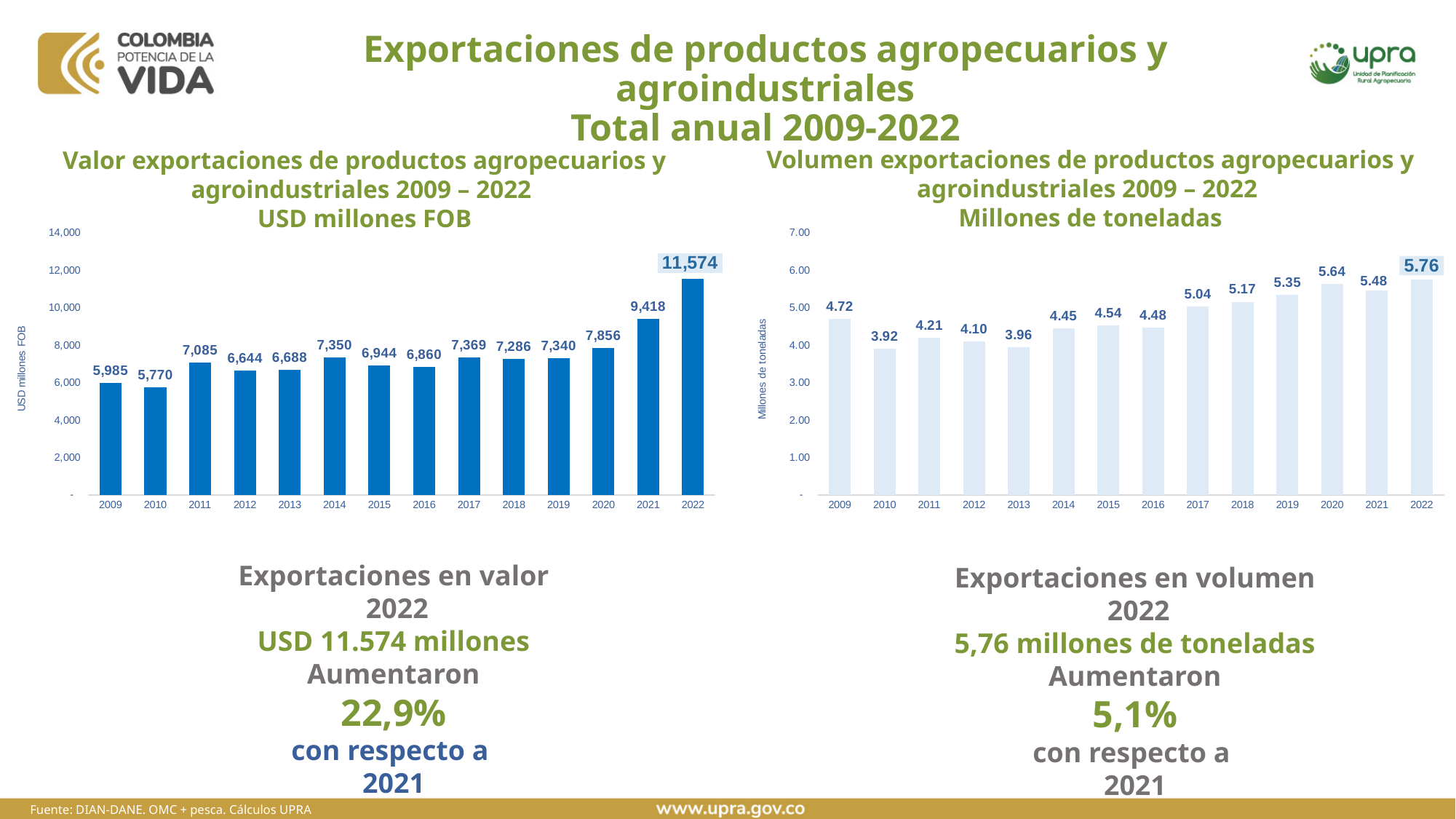
What kind of chart is the right chart (Volumen exportaciones)? bar chart How many years are shown on the x axis of the left chart (Valor exportaciones)? 14 In the left chart (Valor exportaciones), what is the value for 2022? 11,574 In the right chart (Volumen exportaciones), what is the difference between the values for 2020 and 2021? 0.16 What unit is given in the title of the right chart (Volumen exportaciones)? Millones de toneladas In the left chart (Valor exportaciones), which is larger, the value for 2014 or the value for 2015? 2014 In the right chart (Volumen exportaciones), is the value for 2017 greater or less than 5.00? greater In the right chart (Volumen exportaciones), which year has the highest value? 2022 In the left chart (Valor exportaciones), which year has the lowest value? 2010 In the left chart (Valor exportaciones), what is the difference between the values for 2022 and 2021? 2,156 In the left chart (Valor exportaciones), do the values generally rise or fall from 2019 to 2022? rise In the right chart (Volumen exportaciones), what is the value for 2010? 3.92